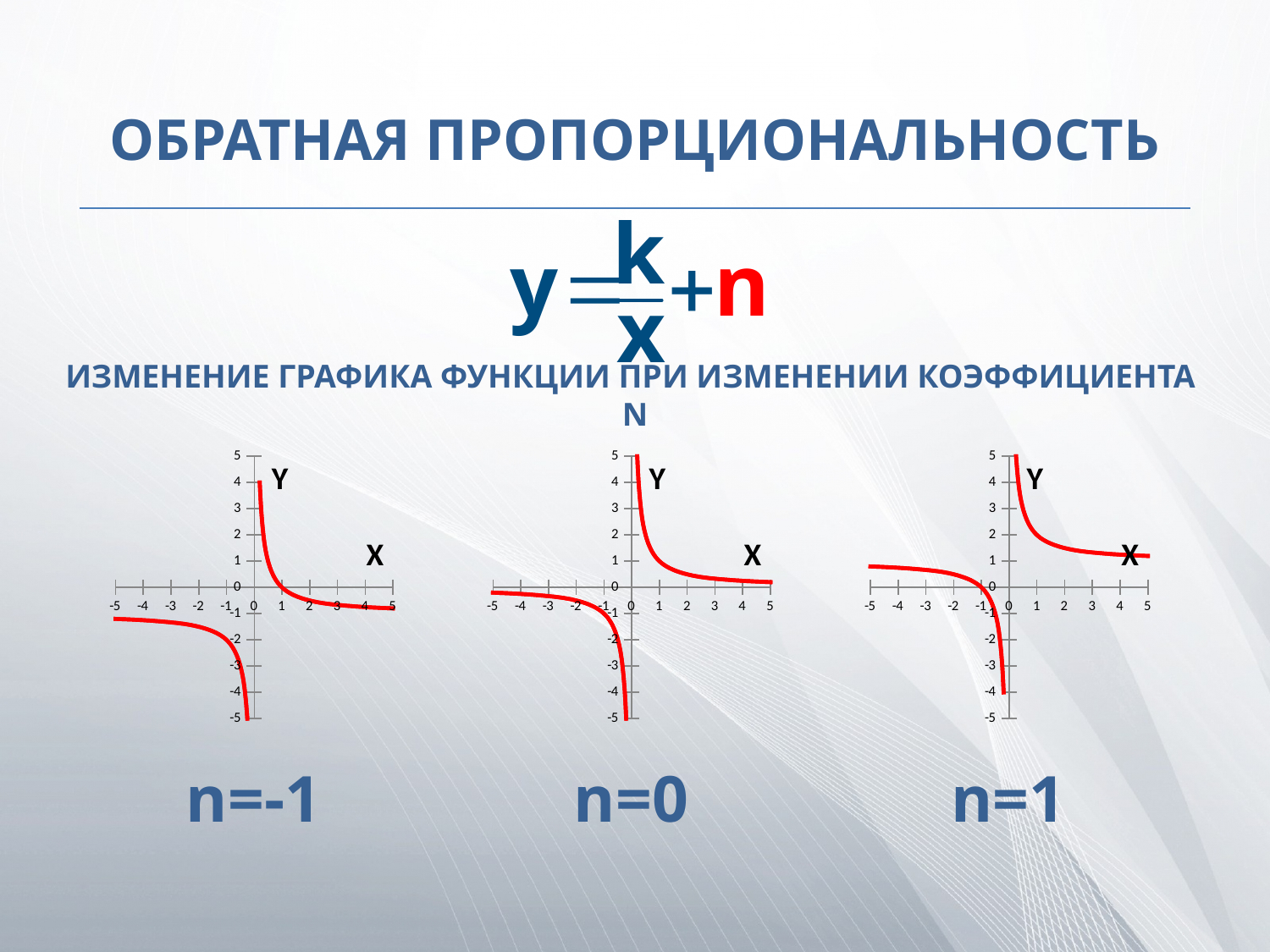
In the chart labelled n=-1, is the value of the curve at x=4 greater or less than 0? less In the chart labelled n=1, is the value of the curve at x=4 greater or less than 2? less In the chart labelled n=0, is the value of the curve at x=1 greater or less than 3? less What is the highest tick value shown on the x axis of the chart labelled n=0? 5 What is the label under the leftmost chart? n=-1 What kind of chart is used in each of the three plots on the slide? line chart In the chart labelled n=-1, do the values of the curve rise or fall as x increases from -5 to -1? fall What is the label under the rightmost chart? n=1 How many charts are shown on the slide? 3 In the chart labelled n=0, do the values of the curve rise or fall as x increases from 1 to 5? fall